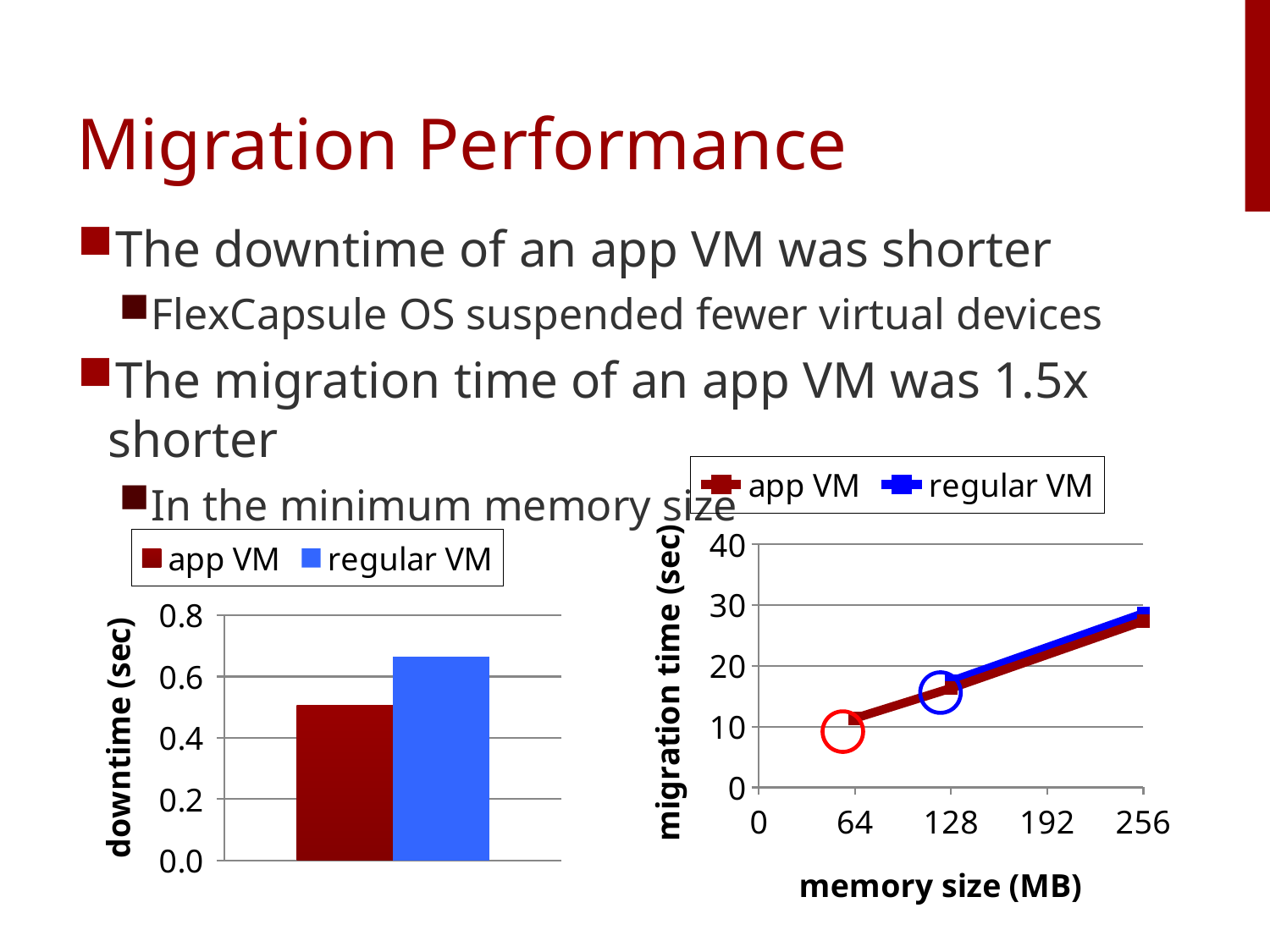
What kind of chart is the right chart showing migration time? line chart In the left downtime chart, which series has the higher downtime, app VM or regular VM? regular VM In the left downtime chart, is the downtime for regular VM greater or less than 0.6? greater In the right migration time chart, is the migration time for app VM at 64 MB greater or less than 20? less What is the x-axis label of the right migration time chart? memory size (MB) What kind of chart is the left chart showing downtime? bar chart How many series does the legend of the right migration time chart list? 2 How many series does the legend of the left downtime chart list? 2 In the right migration time chart, does the migration time rise or fall as memory size increases? rise In the left downtime chart, is the downtime for app VM greater or less than 0.6? less How many bars are plotted in the left downtime chart? 2